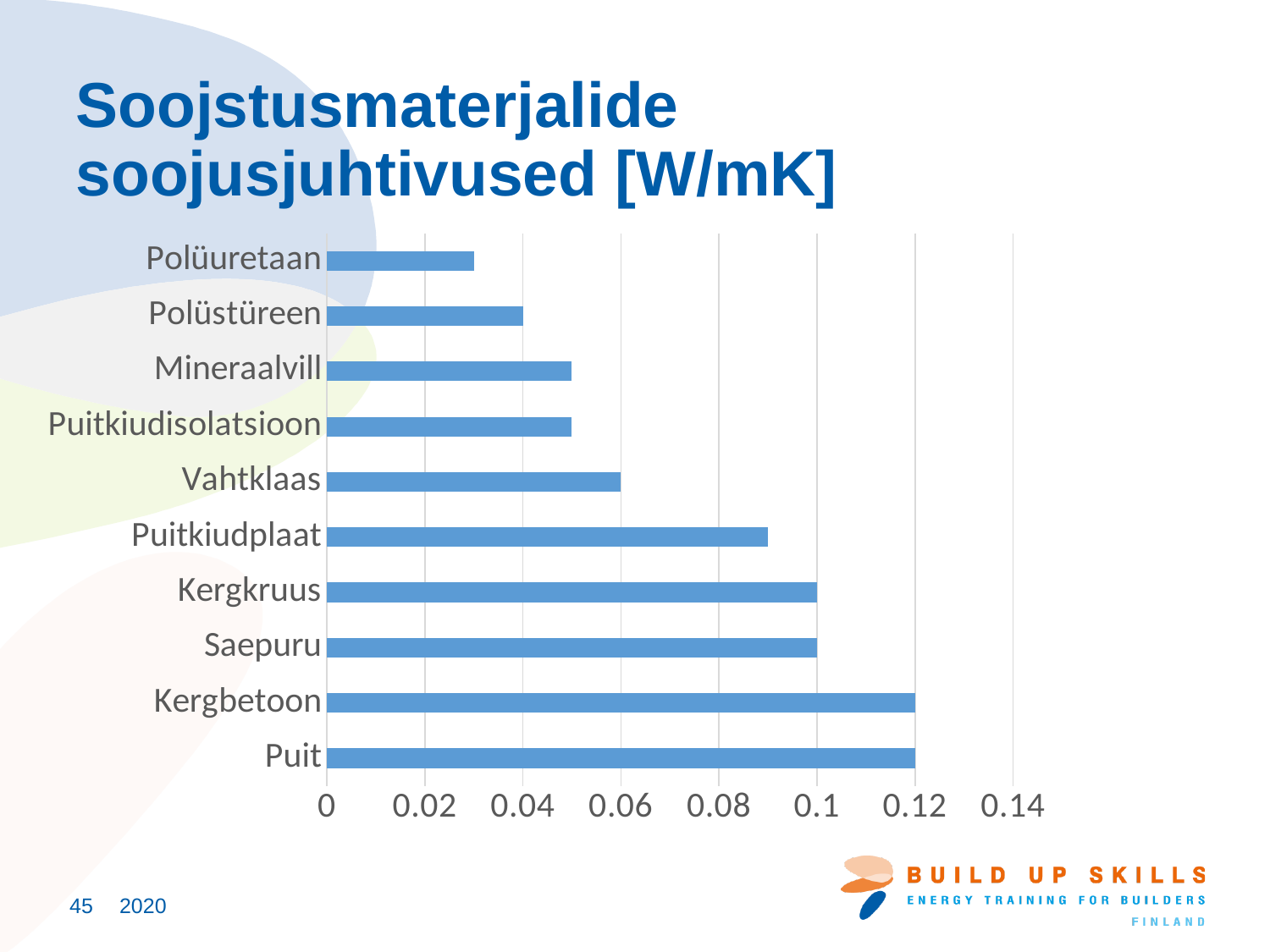
Is the value for Polüuretaan greater or less than 0.04? less What is the title of the slide containing the chart? Soojstusmaterjalide soojusjuhtivused [W/mK] What is the value for Kergkruus? 0.1 How many materials (categories) are shown in the chart? 10 What is the difference between the values for Puit and Kergkruus? 0.02 What is the value for Vahtklaas? 0.06 What kind of chart is shown on the slide? bar chart Which has the larger value, Puitkiudplaat or Vahtklaas? Puitkiudplaat What is the value for Puit? 0.12 Which material has the lowest value in the chart? Polüuretaan What is the value for Polüstüreen? 0.04 Is the value for Puitkiudplaat greater or less than 0.08? greater